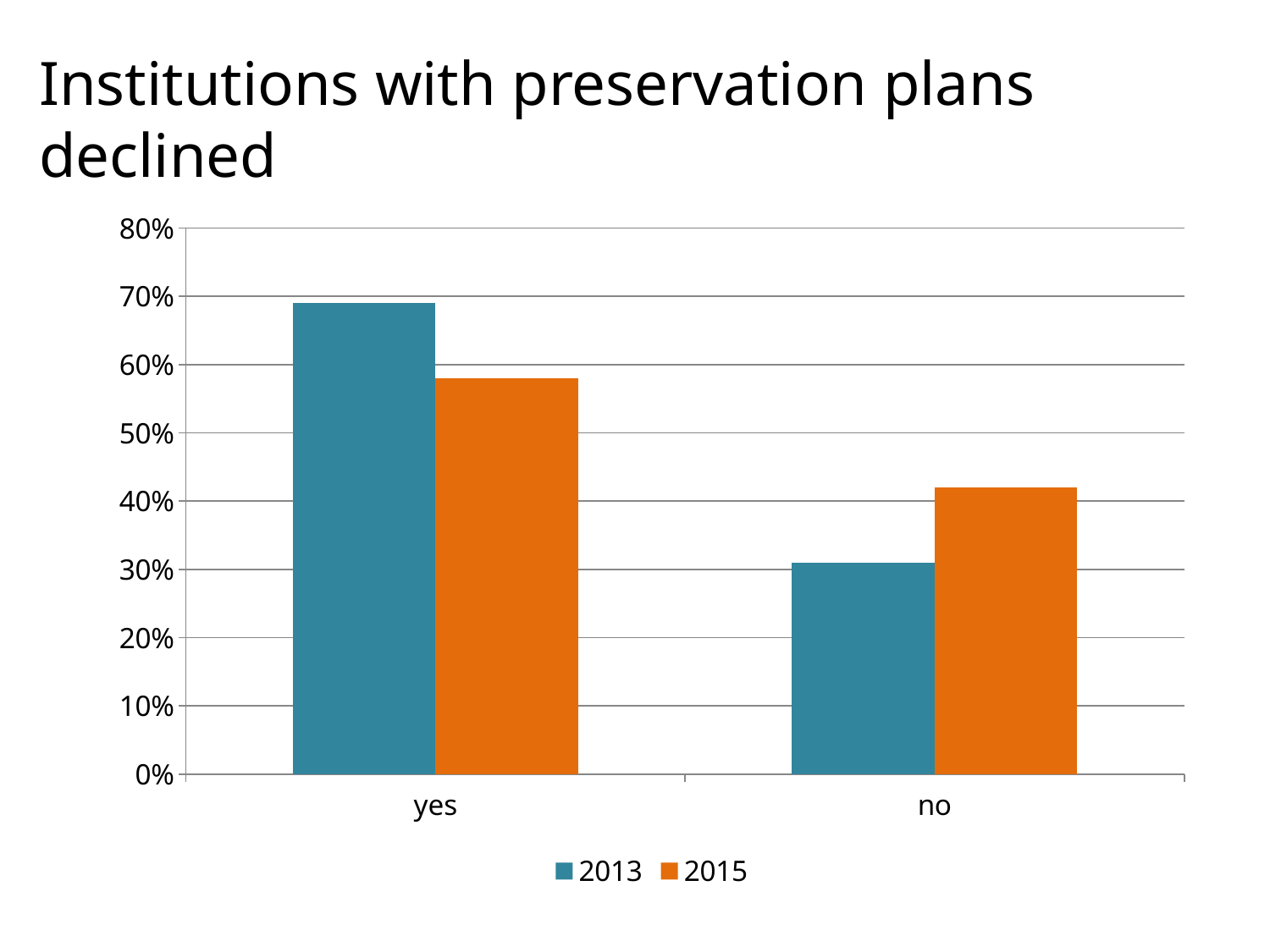
For the "no" category, which series has the larger value, 2013 or 2015? 2015 Is the 2015 value for "yes" greater or less than 60%? less Which bar is the tallest in the chart? 2013 for "yes" What is the title of the slide containing the chart? Institutions with preservation plans declined Which series are listed in the legend? 2013 and 2015 What kind of chart is shown on the slide? bar chart Is the 2013 value for "no" greater or less than 40%? less How many categories are shown on the x axis? 2 For the "yes" category, which series has the larger value, 2013 or 2015? 2013 How many series does the legend list? 2 Is the 2015 value for "no" greater or less than 40%? greater